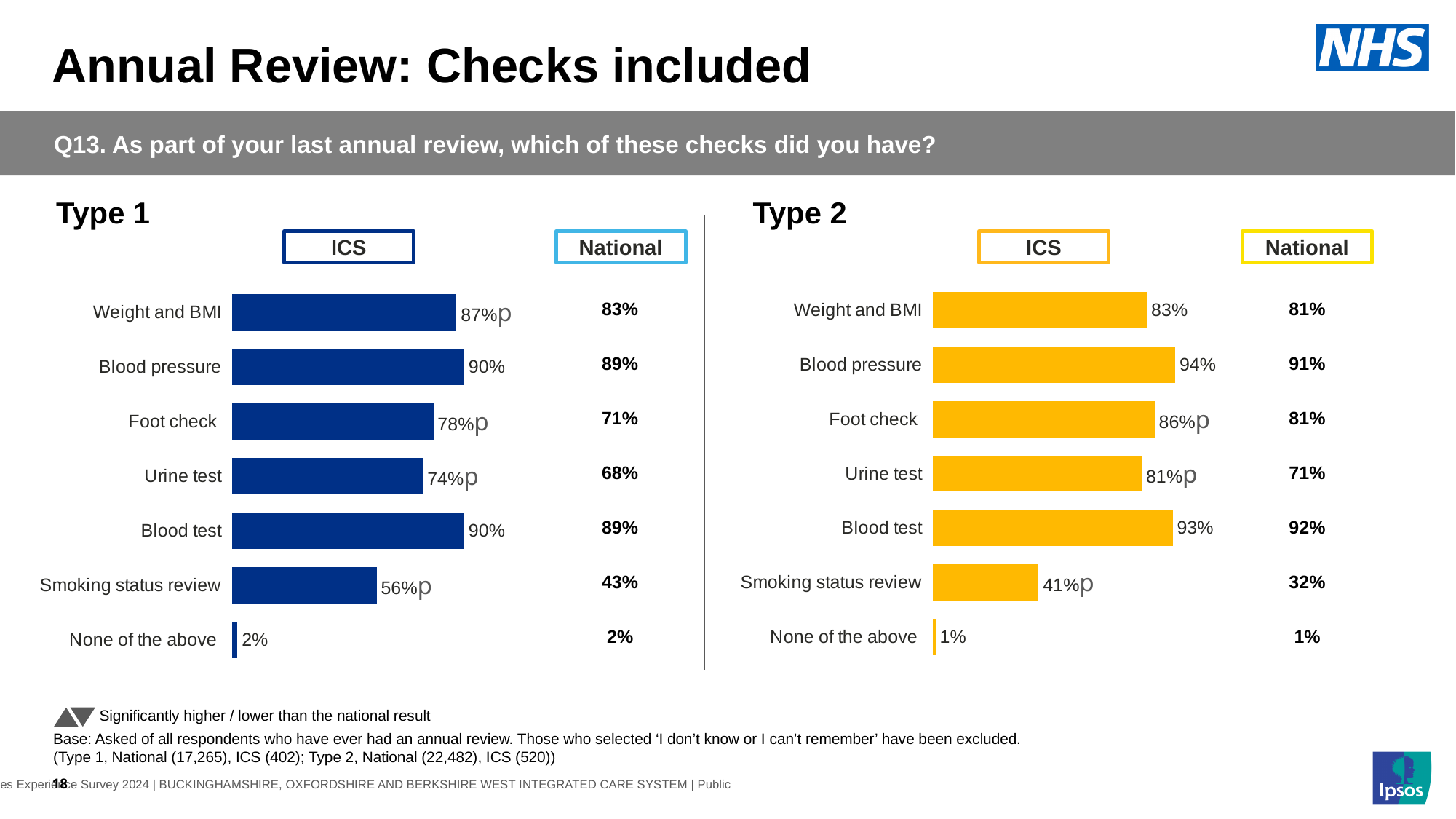
How many categories are shown in the Type 1 chart? 7 In the Type 2 chart, what is the ICS value for Smoking status review? 41% In the Type 2 chart, which check has the highest ICS value? Blood pressure In the Type 1 chart, which category has the lowest ICS value? None of the above In the Type 1 chart, what is the difference between the ICS and National values for Smoking status review? 13 percentage points What colour are the ICS bars in the Type 2 chart? Yellow In the Type 2 chart, what is the difference between the ICS values for Blood test and Weight and BMI? 10 percentage points In the Type 1 chart, what is the ICS value for Foot check? 78% In the Type 1 chart, which is larger: the ICS value for Foot check or the ICS value for Urine test? Foot check In the Type 2 chart, which is larger for Blood pressure: the ICS value or the National value? ICS What type of chart is used for the Type 2 ICS results? Bar chart In the Type 1 chart, what is the National value for Urine test? 68%